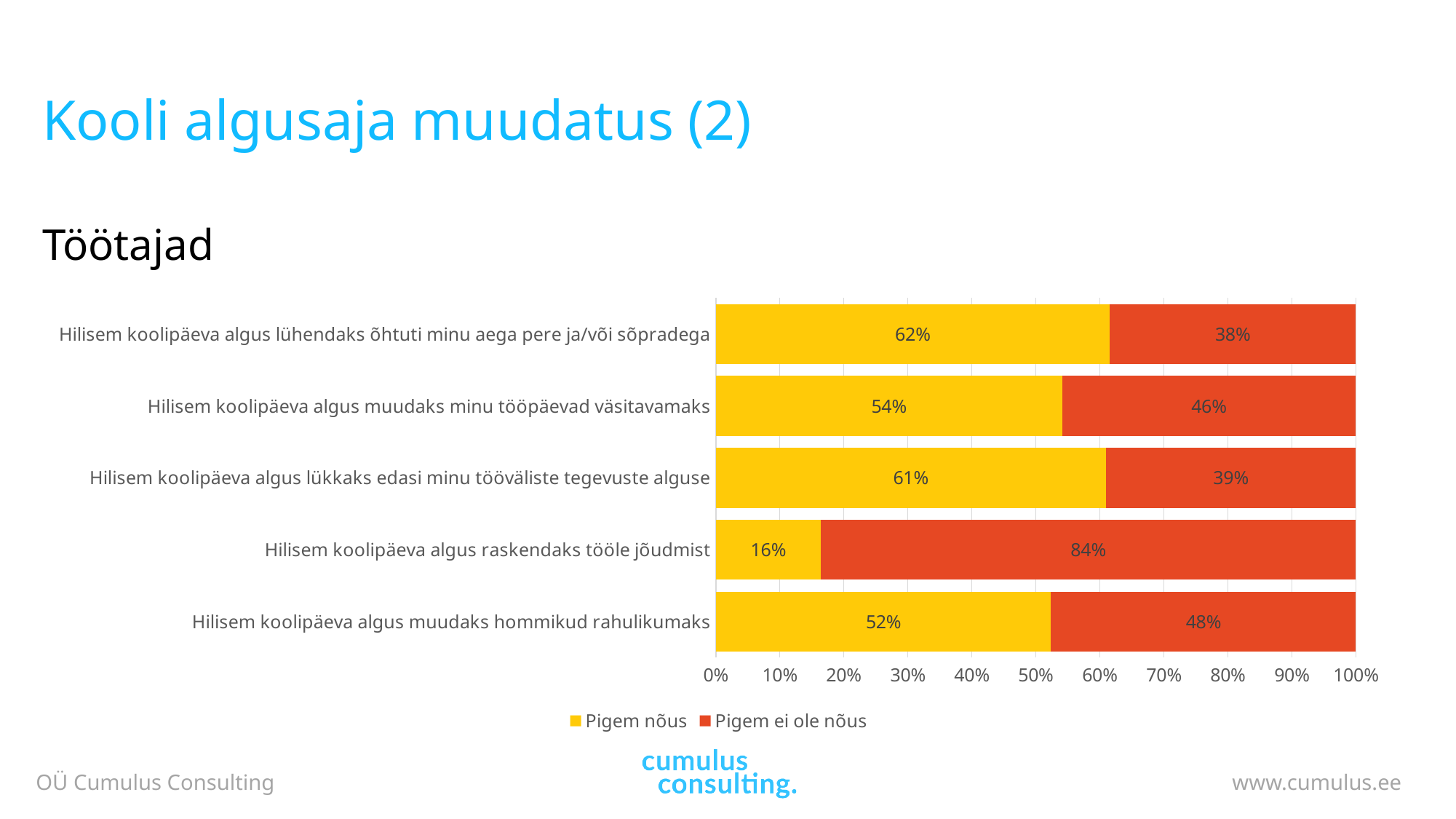
What kind of chart is shown on the slide? Stacked bar chart Which is larger for "Hilisem koolipäeva algus lükkaks edasi minu tööväliste tegevuste alguse": "Pigem nõus" or "Pigem ei ole nõus"? Pigem nõus What is the total of the stacked bar for "Hilisem koolipäeva algus muudaks minu tööpäevad väsitavamaks"? 100% What percentage of respondents answered "Pigem nõus" to "Hilisem koolipäeva algus raskendaks tööle jõudmist"? 16% Which statement has the highest "Pigem nõus" share? Hilisem koolipäeva algus lühendaks õhtuti minu aega pere ja/või sõpradega How many series does the legend list? 2 What is the "Pigem ei ole nõus" value for "Hilisem koolipäeva algus muudaks minu tööpäevad väsitavamaks"? 46% Which colour represents "Pigem ei ole nõus" in the chart? Red What is the difference between the "Pigem ei ole nõus" and "Pigem nõus" values for "Hilisem koolipäeva algus raskendaks tööle jõudmist"? 68% How many statements (categories) are shown in the chart? 5 Which statement has the lowest "Pigem nõus" share? Hilisem koolipäeva algus raskendaks tööle jõudmist What is the "Pigem nõus" value for "Hilisem koolipäeva algus muudaks hommikud rahulikumaks"? 52%